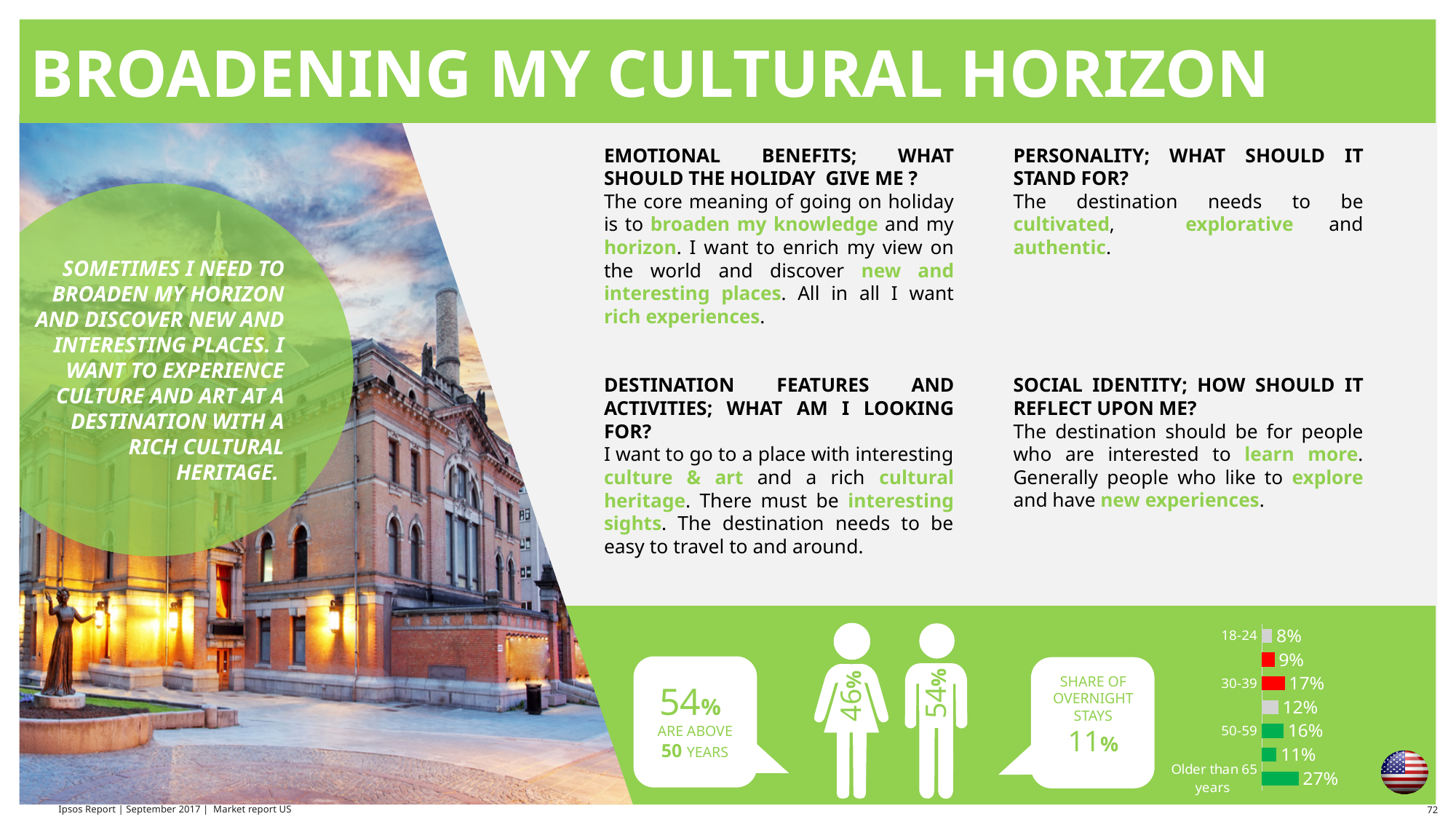
In the age-group bar chart at the bottom right, which labelled age group has the highest value? Older than 65 years In the age-group bar chart at the bottom right, what is the value for the 50-59 group? 16% In the age-group bar chart at the bottom right, which is larger: the value for 30-39 or the value for 50-59? 30-39 How many bars are shown in the age-group bar chart at the bottom right? 7 In the age-group bar chart at the bottom right, what is the value for the 30-39 group? 17% In the age-group bar chart at the bottom right, what is the value for the 18-24 group? 8% In the age-group bar chart at the bottom right, what is the difference between the 30-39 value and the 50-59 value? 1 percentage point In the age-group bar chart at the bottom right, what is the difference between the 'Older than 65 years' value and the 18-24 value? 19 percentage points In the age-group bar chart at the bottom right, what colour is the bar for the 'Older than 65 years' group? Green In the age-group bar chart at the bottom right, which labelled age group has the lowest value? 18-24 In the age-group bar chart at the bottom right, what is the value for the 'Older than 65 years' group? 27% What type of chart is the age-group chart at the bottom right of the slide? Bar chart